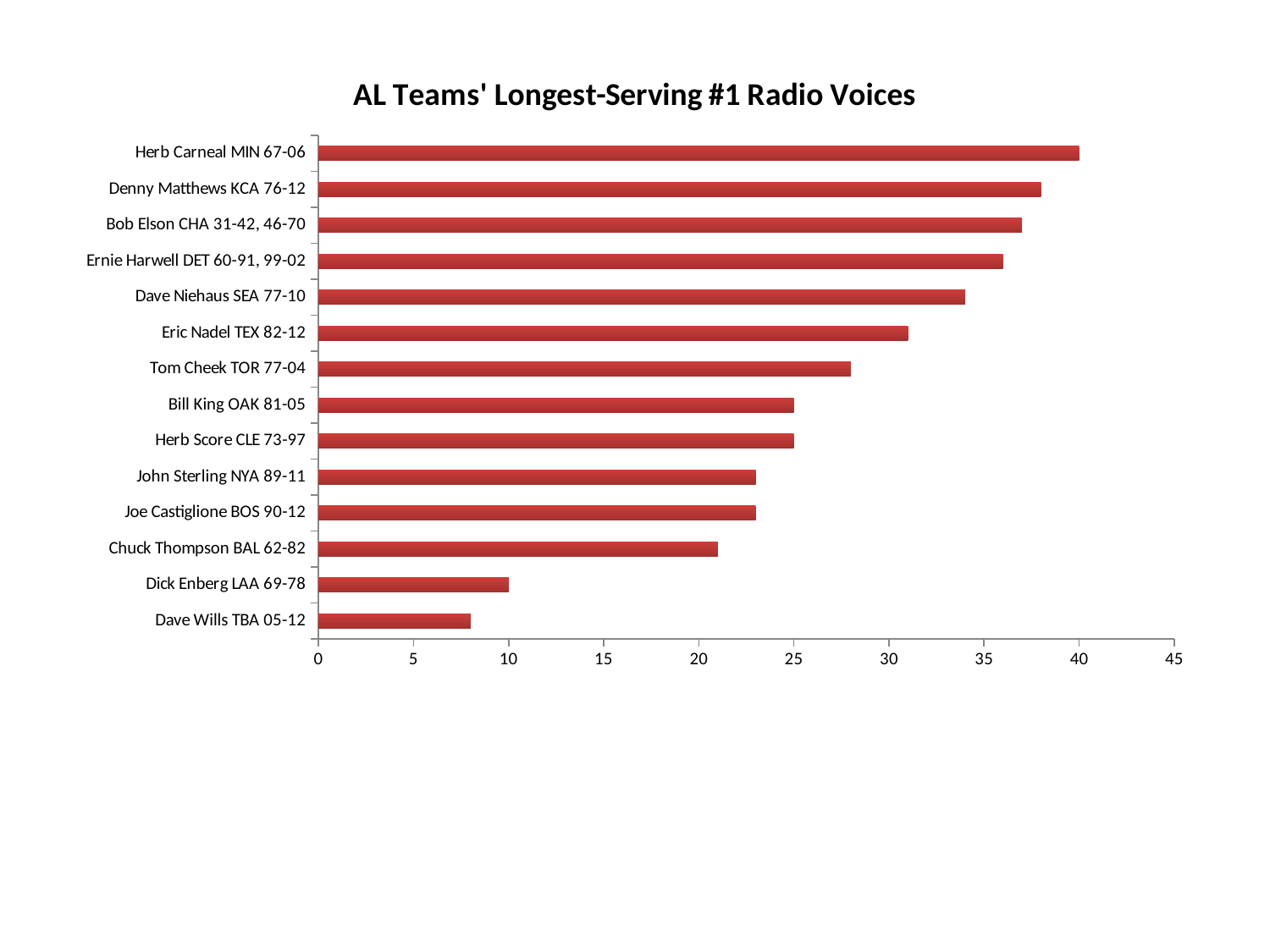
Is the value for Tom Cheek TOR 77-04 greater or less than 30? less What is the title of the chart? AL Teams' Longest-Serving #1 Radio Voices What is the difference between the values for Herb Carneal MIN 67-06 and Dick Enberg LAA 69-78? 30 How many radio voices (bars) are shown in the chart? 14 What is the value for Herb Carneal MIN 67-06? 40 Which radio voice has the longest bar? Herb Carneal MIN 67-06 What is the value for Bill King OAK 81-05? 25 Which is larger, the value for Eric Nadel TEX 82-12 or the value for Tom Cheek TOR 77-04? Eric Nadel TEX 82-12 Is the value for Denny Matthews KCA 76-12 greater or less than 35? greater Which radio voice has the shortest bar? Dave Wills TBA 05-12 What is the value for Dick Enberg LAA 69-78? 10 What kind of chart is shown on the slide? bar chart